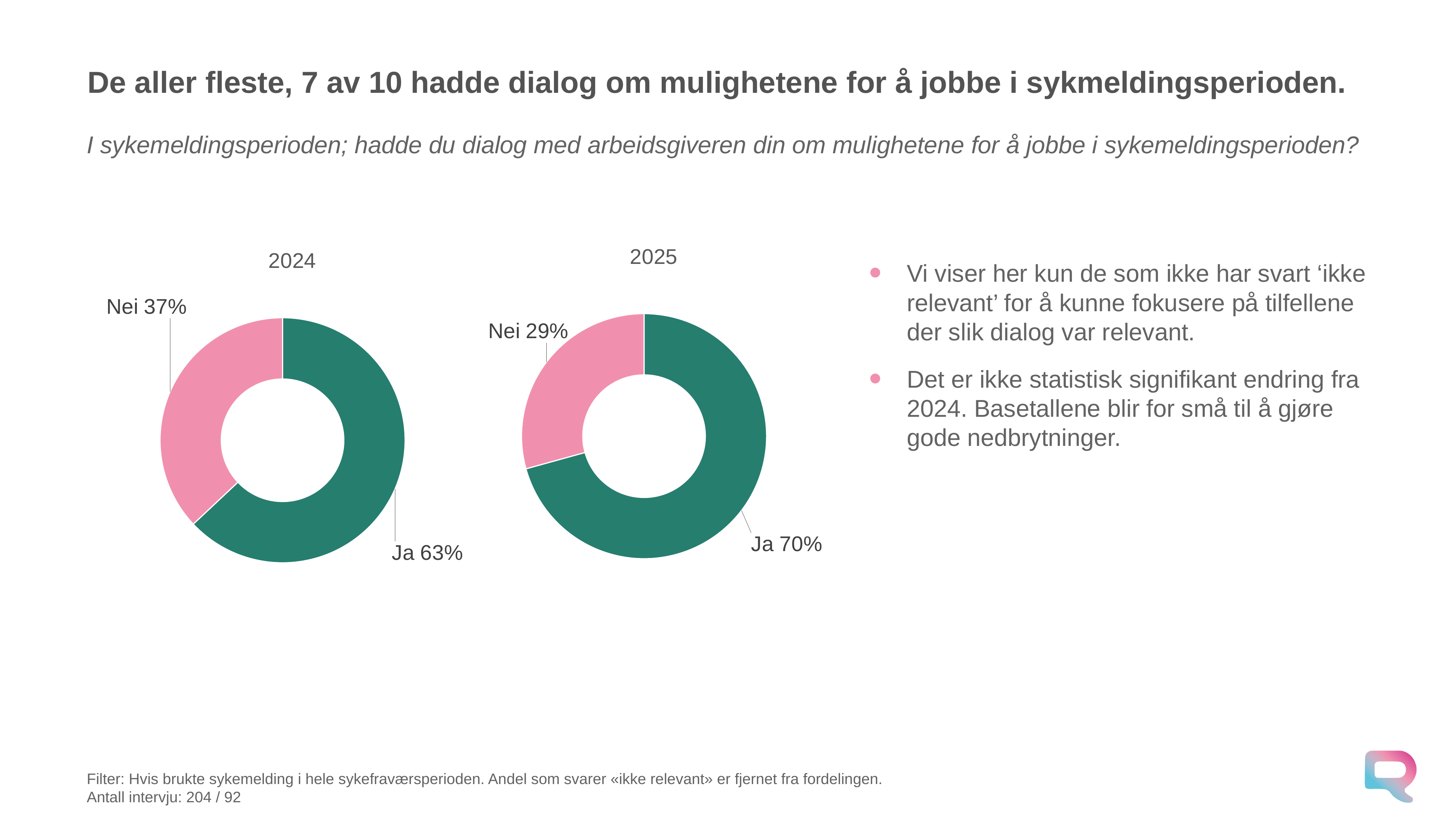
How many categories does the 2025 chart show? 2 In the 2024 chart, what is the difference between Ja and Nei? 26 percentage points Is the value for Ja larger in the 2024 chart or the 2025 chart? 2025 In the 2025 chart, what colour is the Nei slice? Pink In the 2024 chart, which category has the smallest share? Nei In the 2025 chart, which category has the largest share? Ja In the 2024 chart, what is the value for Ja? 63% What kind of chart is the 2024 chart? Doughnut (pie) chart In the 2025 chart, what is the value for Nei? 29% In the 2024 chart, what is the value for Nei? 37% In the 2025 chart, what is the value for Ja? 70% What is the difference between the Nei value in the 2024 chart and the Nei value in the 2025 chart? 8 percentage points